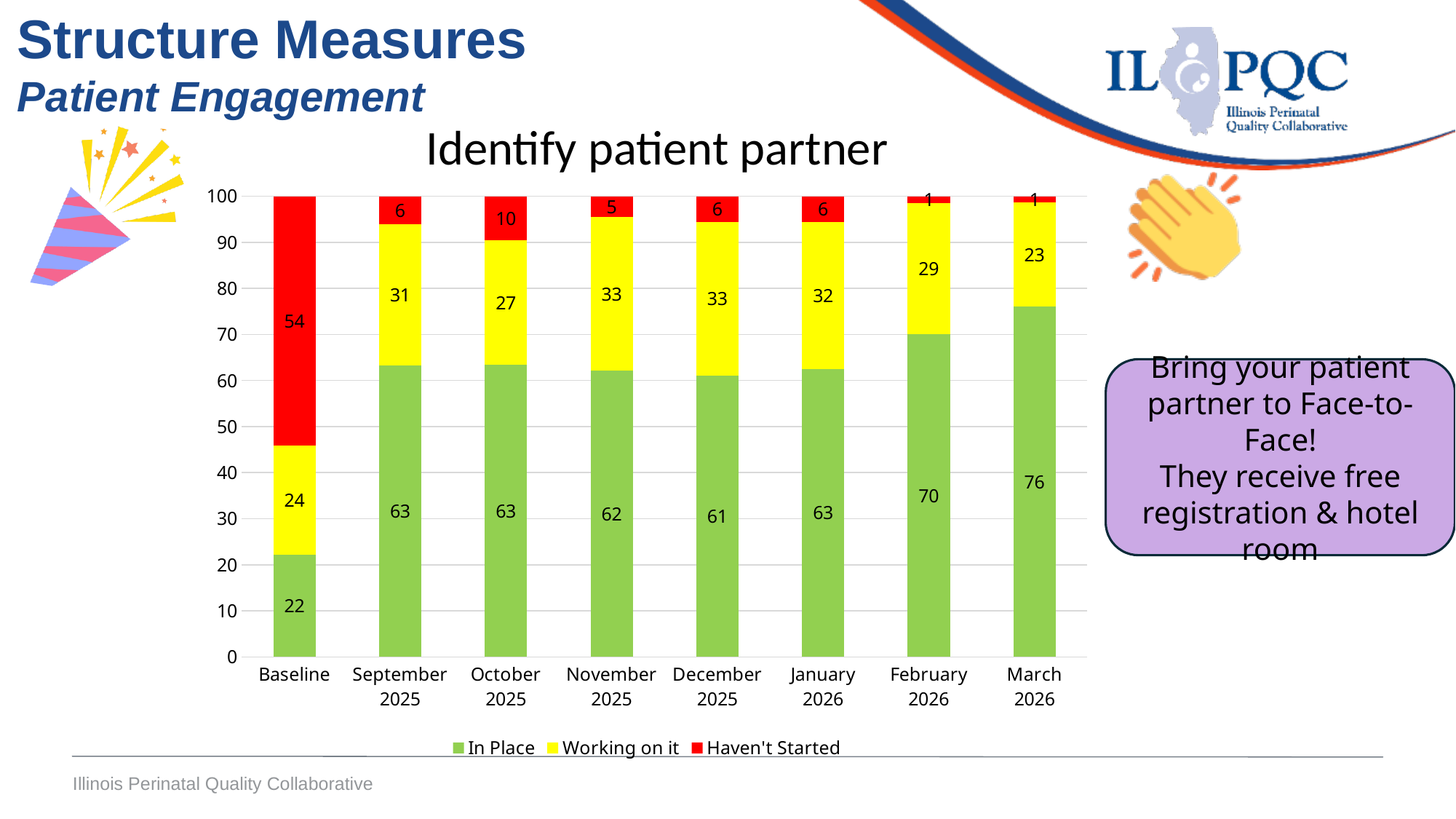
What is the Working on it value for October 2025? 27 What is the difference between the In Place value for March 2026 and the In Place value for Baseline? 54 How many categories are shown on the x axis? 8 Which is larger, the Haven't Started value for October 2025 or for September 2025? October 2025 What is the title of the chart? Identify patient partner Which category has the lowest In Place value? Baseline What is the Haven't Started value for Baseline? 54 What type of chart is shown on the slide? stacked bar chart Which category has the highest In Place value? March 2026 What is the total of the stacked bar for Baseline? 100 How many series does the legend list? 3 What is the In Place value for March 2026? 76